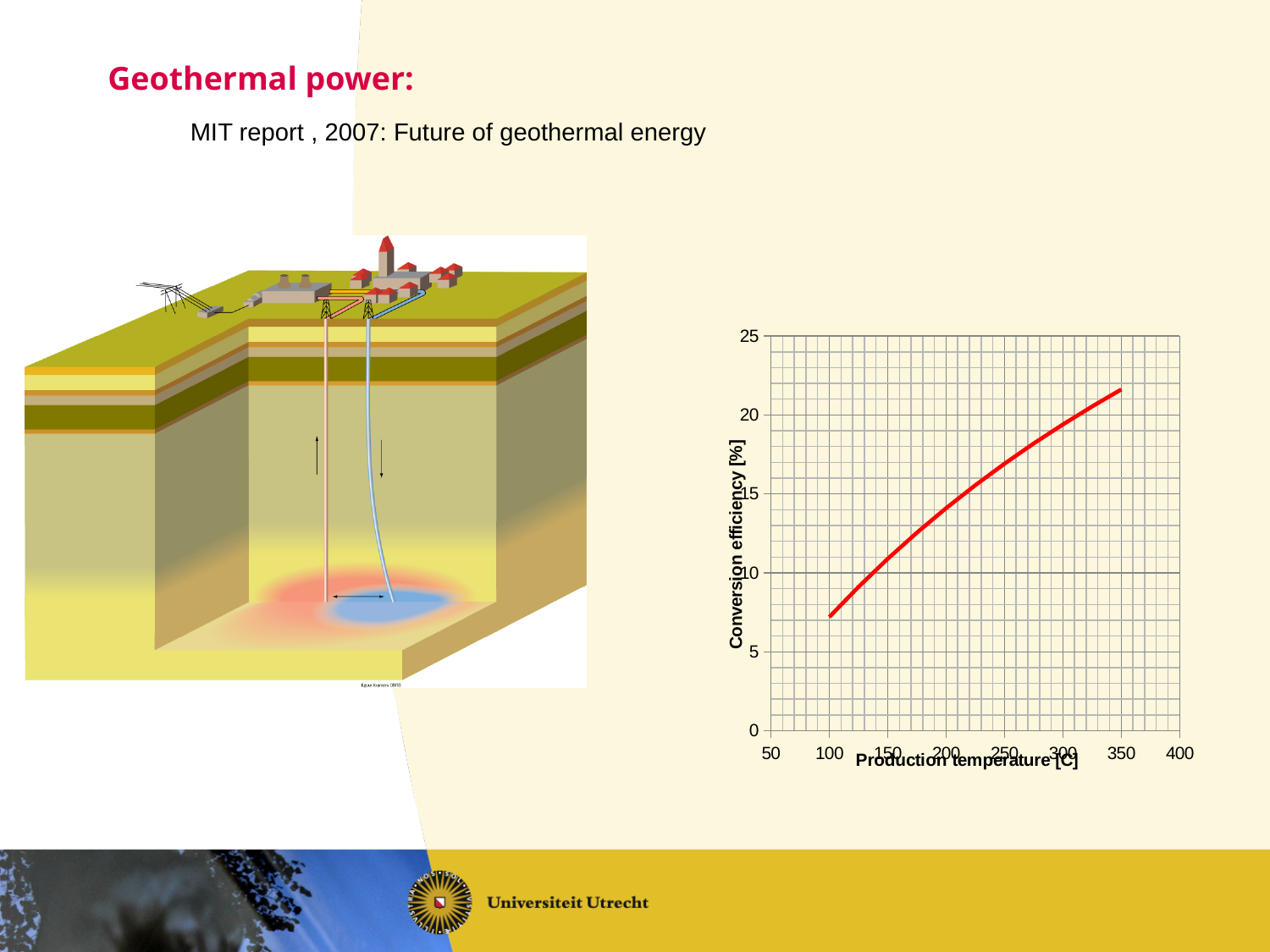
Which is larger, the conversion efficiency at 150 C or at 250 C? 250 C What is the label of the x axis of the chart? Production temperature [C] What kind of chart is shown on the slide? line chart Does the conversion efficiency rise or fall as the production temperature increases? rise What is the label of the y axis of the chart? Conversion efficiency [%] Is the conversion efficiency at a production temperature of 350 C greater or less than 20%? greater Is the conversion efficiency at a production temperature of 150 C greater or less than 15%? less Is the conversion efficiency at a production temperature of 100 C greater or less than 10%? less What is the highest value shown on the y axis of the chart? 25